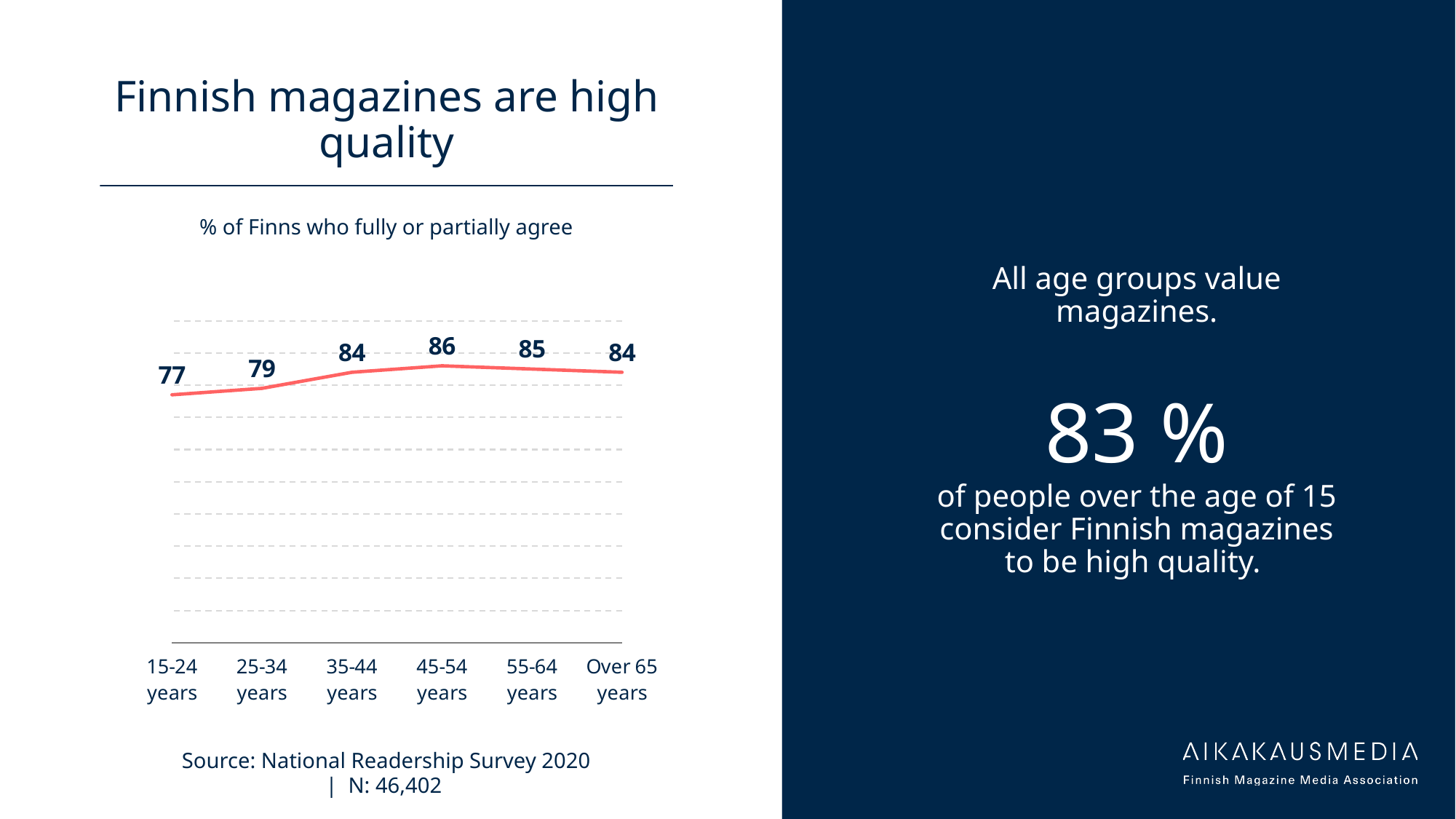
Does the value rise or fall from 15-24 years to 45-54 years? Rise Which age group has the highest value? 45-54 years What percentage of Finns aged 15-24 years fully or partially agree that Finnish magazines are high quality? 77 Which age group has the lowest value? 15-24 years What kind of chart is shown on the slide? Line chart How many age groups are plotted on the chart? 6 What is the value for the 25-34 years age group? 79 What is the value for the 45-54 years age group? 86 What is the value for the Over 65 years age group? 84 What is the difference between the values for 45-54 years and 15-24 years? 9 What is the title of the chart? Finnish magazines are high quality Which is larger, the value for 55-64 years or the value for 25-34 years? 55-64 years